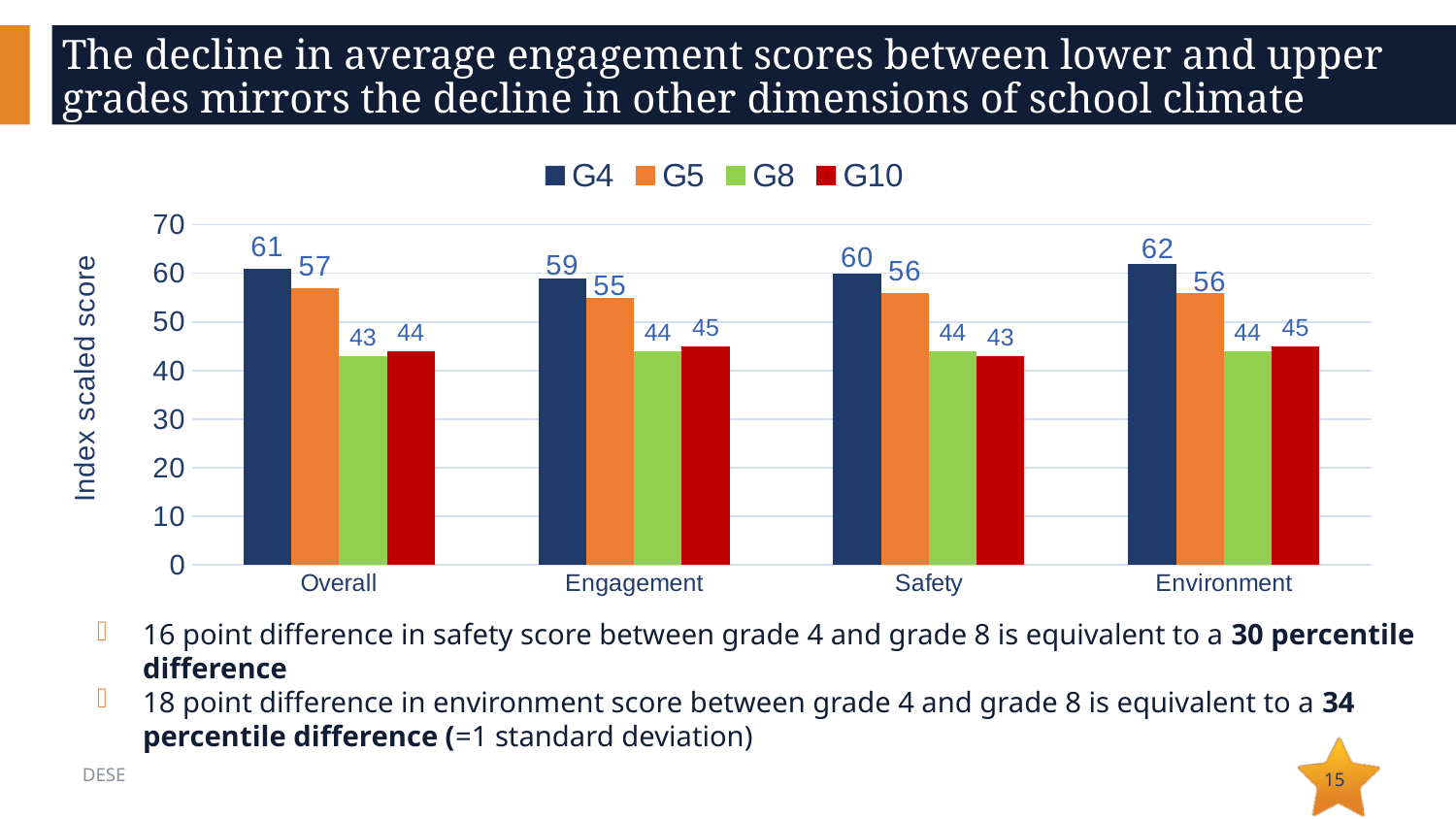
Which category has the highest G4 value? Environment What is the G4 value for Safety? 60 What is the label of the y axis? Index scaled score How many series does the legend list? 4 What is the difference between the G4 and G8 values for Environment? 18 Which category has the lowest G10 value? Safety What kind of chart is shown on the slide? Bar chart How many categories are shown on the x axis? 4 What is the G8 value for Overall? 43 What is the G10 value for Engagement? 45 Which is larger for Safety, the G8 value or the G10 value? G8 What is the difference between the G4 and G5 values for Overall? 4